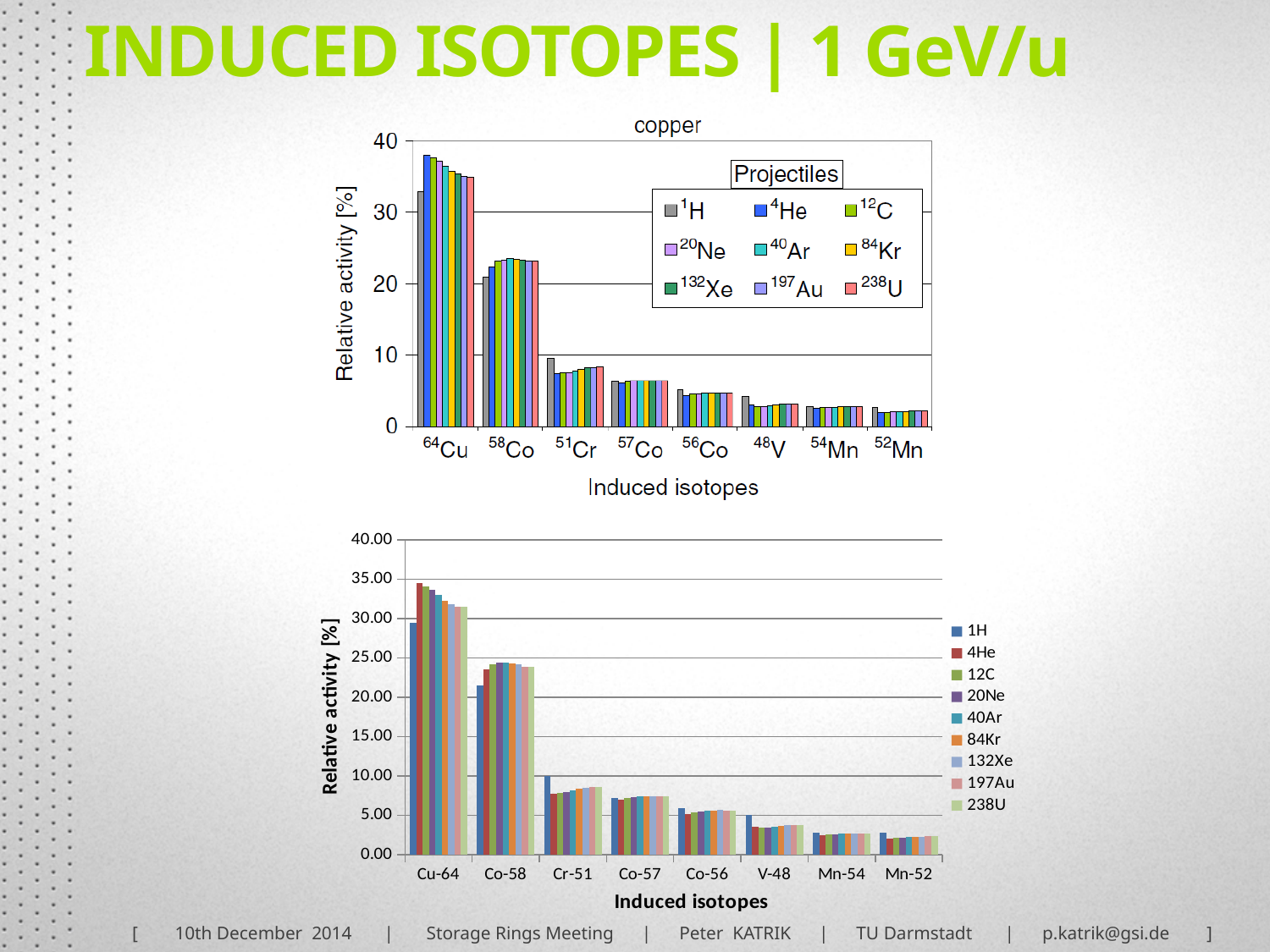
In the top chart titled "copper", what is the title of the legend box? Projectiles In the top chart titled "copper", do the relative activities generally rise or fall from 64Cu to 52Mn along the x axis? fall In the top chart titled "copper", which induced isotope has the highest relative activity? 64Cu In the bottom chart, how many series does the legend list? 9 In the top chart titled "copper", what kind of chart is shown? bar chart In the top chart titled "copper", how many induced isotopes are shown on the x axis? 8 In the top chart titled "copper", is the relative activity for 1H at 64Cu greater or less than 30? greater In the top chart titled "copper", how many projectiles does the legend list? 9 In the bottom chart, is the relative activity for 4He at Cu-64 greater or less than 30.00? greater In the bottom chart, which has the larger relative activity for 1H: Cu-64 or Co-58? Cu-64 In the top chart titled "copper", is the relative activity for 4He at 58Co greater or less than 20? greater In the bottom chart, how many induced isotopes are shown on the x axis? 8